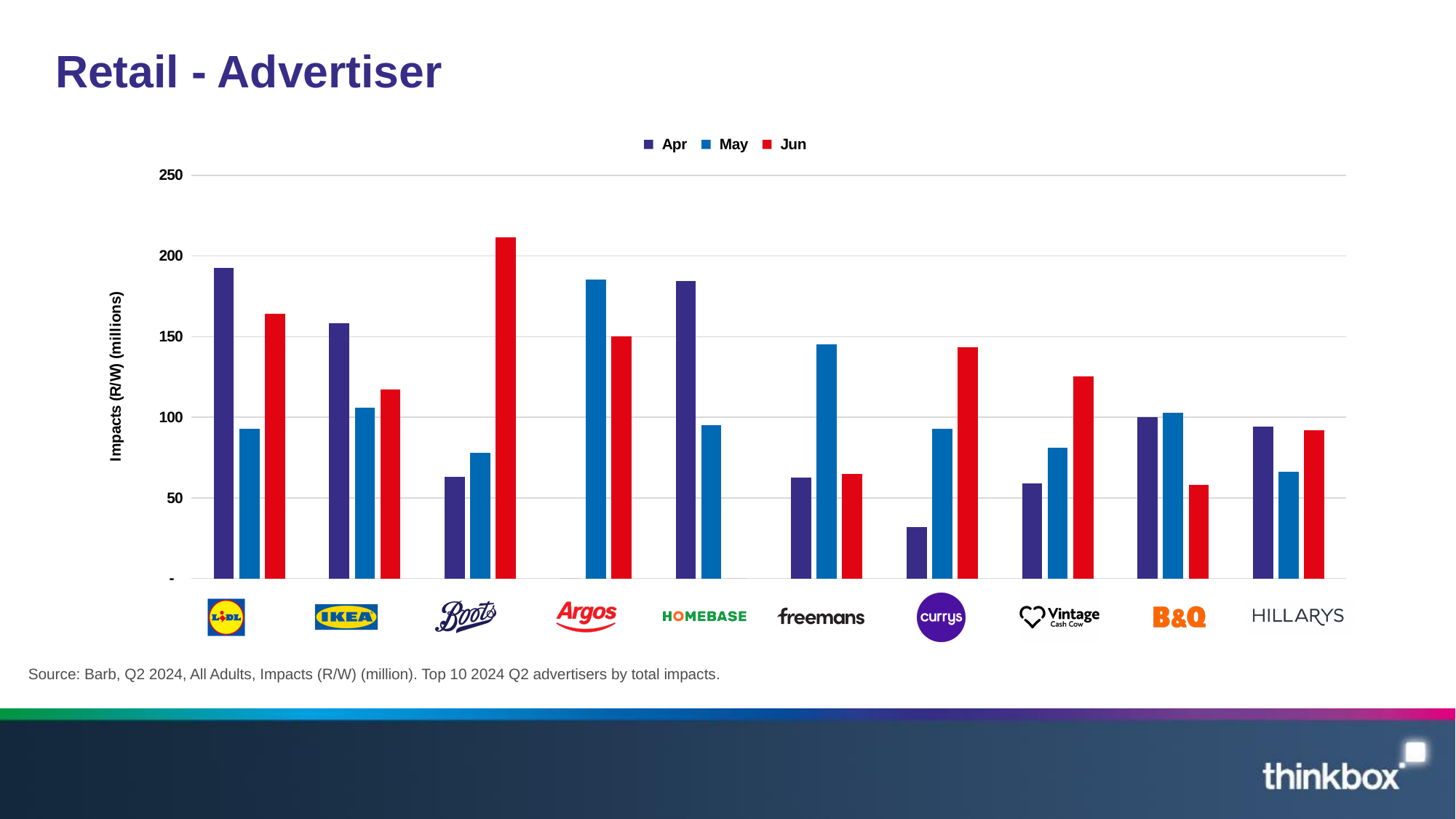
How many series does the legend list? 3 What kind of chart is shown on the slide? bar chart Do the values for Boots rise or fall from Apr to Jun? rise Is the Apr value for Lidl greater or less than 150? greater What is the label on the y axis? Impacts (R/W) (millions) Is the Jun value for Boots greater or less than 200? greater Which advertiser has the highest Jun bar? Boots Is the Apr value for Currys greater or less than 50? less Which advertiser has the lowest Apr bar among those with an Apr bar? Currys For Lidl, which is larger: the Apr value or the May value? Apr How many advertisers are shown along the x axis? 10